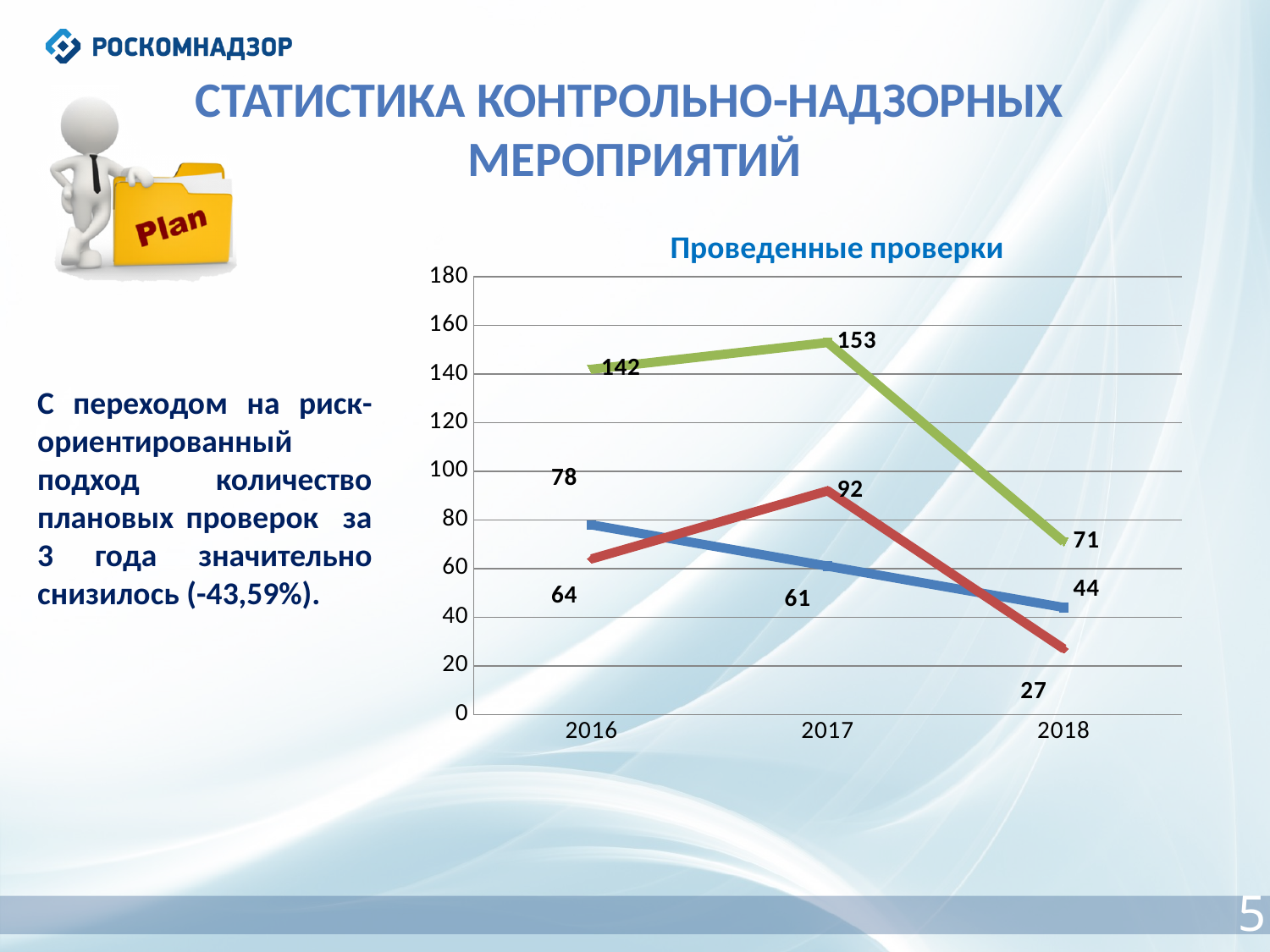
How many years are shown on the x axis of the chart? 3 What is the title of the chart? Проведенные проверки Does the blue line rise or fall from 2016 to 2018? fall What is the difference between the green line's values in 2017 and 2018? 82 What is the difference between the blue line's values in 2016 and 2018? 34 What is the value of the red line in 2018? 27 What is the value of the blue line in 2016? 78 Which is larger in 2017: the red line's value or the blue line's value? the red line (92) In which year does the red line have its lowest value? 2018 What is the value of the green line in 2017? 153 In which year does the green line reach its highest value? 2017 What type of chart is shown under the title "Проведенные проверки"? line chart